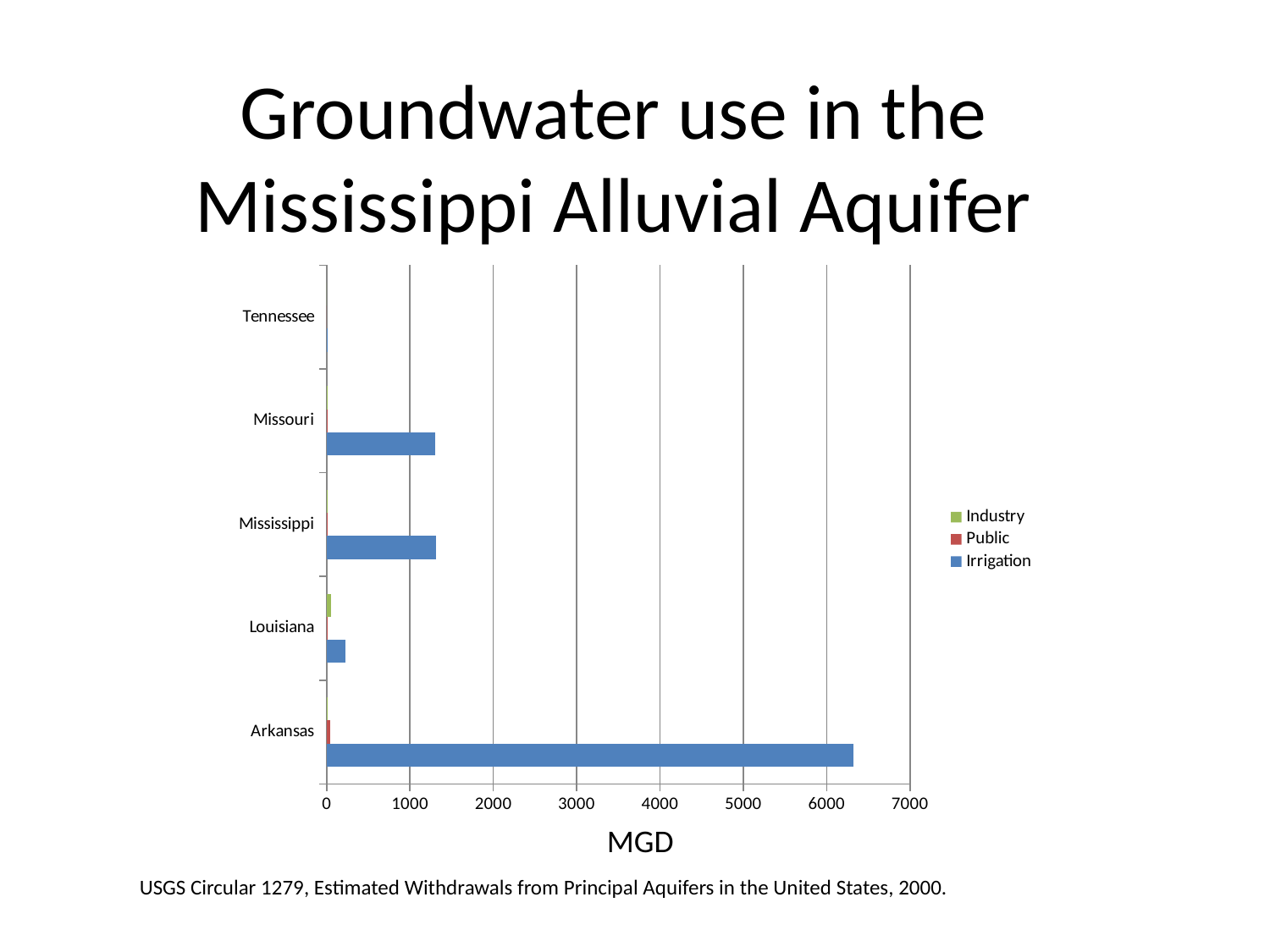
Which is larger, the Irrigation value for Arkansas or the Irrigation value for Louisiana? Arkansas How many states are listed on the vertical axis of the chart? 5 Is the Irrigation value for Missouri greater or less than 1000? greater What is the label on the horizontal axis of the chart? MGD Which state has the highest Irrigation value? Arkansas Which state has the lowest Irrigation value? Tennessee Is the Irrigation value for Mississippi greater or less than 2000? less What kind of chart is shown on the slide? bar chart How many series does the chart's legend list? 3 Which series is shown in blue in the chart's legend? Irrigation Is the Irrigation value for Arkansas greater or less than 6000? greater